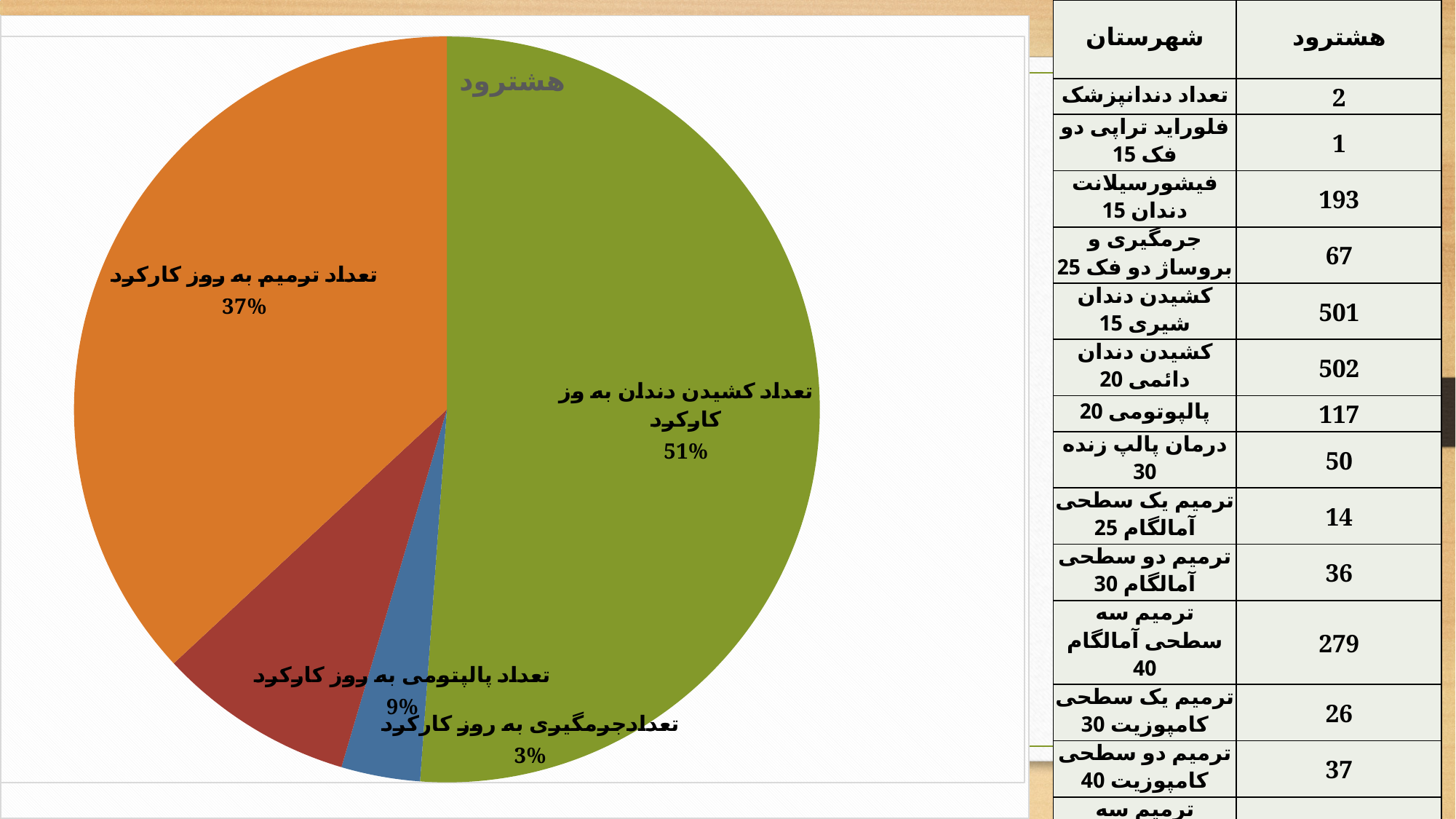
What share of the pie does تعداد ترمیم به روز کارکرد have? 37% What share of the pie does تعداد کشیدن دندان به روز کارکرد have? 51% Which slice of the pie chart is the smallest? تعداد جرمگیری به روز کارکرد What is the title of the pie chart? هشترود What colour is the slice for تعداد ترمیم به روز کارکرد? orange How many slices does the pie chart have? 4 What share of the pie does تعداد جرمگیری به روز کارکرد have? 3% What kind of chart is shown on the slide? pie chart What is the difference in percentage points between تعداد کشیدن دندان به روز کارکرد and تعداد ترمیم به روز کارکرد? 14% Which slice of the pie chart is the largest? تعداد کشیدن دندان به روز کارکرد Which is larger, the share for تعداد پالپوتومی به روز کارکرد or the share for تعداد جرمگیری به روز کارکرد? تعداد پالپوتومی به روز کارکرد